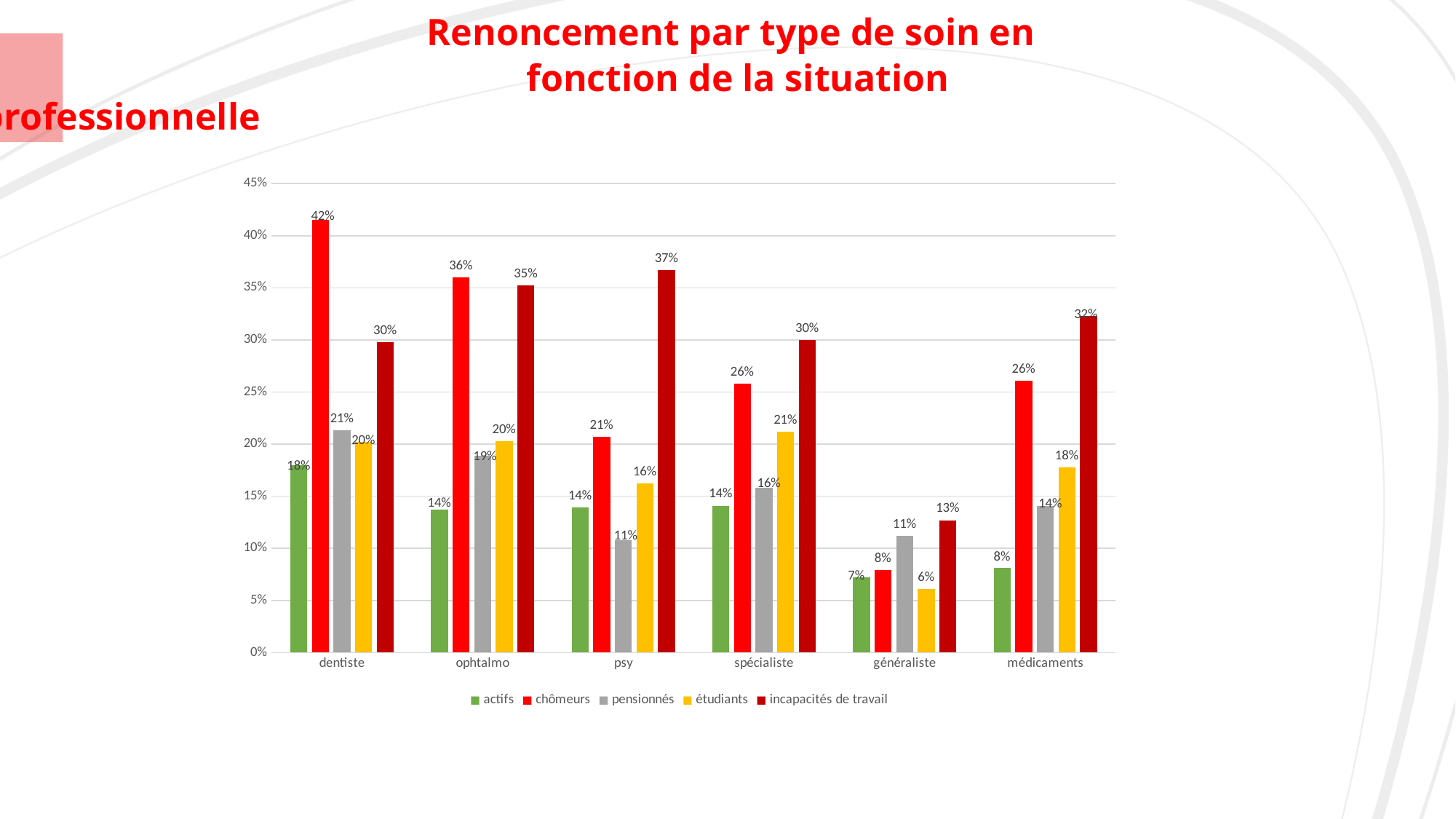
Which is larger: the incapacités de travail value for psy or for spécialiste? psy What is the value for chômeurs in the dentiste category? 42% How many series does the legend list? 5 What is the value for étudiants in the médicaments category? 18% What kind of chart is shown on the slide? bar chart What is the value for pensionnés in the généraliste category? 11% What is the difference between the chômeurs and actifs values in the ophtalmo category? 22 percentage points What is the value for incapacités de travail in the psy category? 37% How many care-type categories are shown on the x axis? 6 Which series has the highest value in the généraliste category? incapacités de travail In which category is the chômeurs value the highest? dentiste In which category is the étudiants value the lowest? généraliste